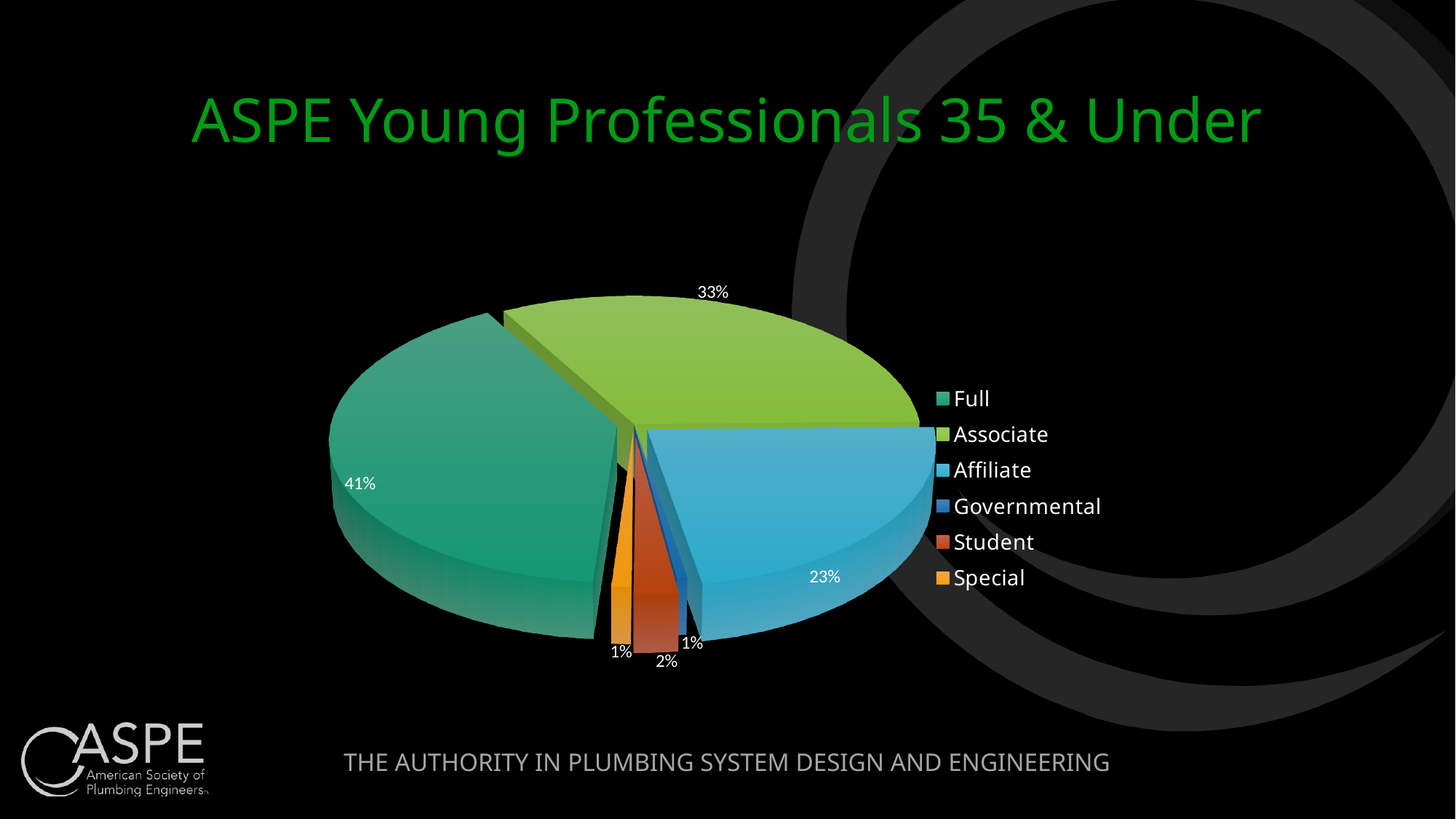
How many categories does the legend list? 6 What kind of chart is shown on the slide? pie chart What is the title of the slide containing the pie chart? ASPE Young Professionals 35 & Under Which category is larger, Associate or Affiliate? Associate What is the difference in percentage points between the Full and Associate slices? 8 What share of ASPE Young Professionals 35 & Under are Full members? 41% Which legend entry is shown in orange? Special What share of the pie is the Associate category? 33% Which category has the largest share of the pie? Full What percentage is shown for the Student slice? 2% What percentage is shown for the Affiliate slice? 23% What is the difference in percentage points between the Associate and Affiliate slices? 10